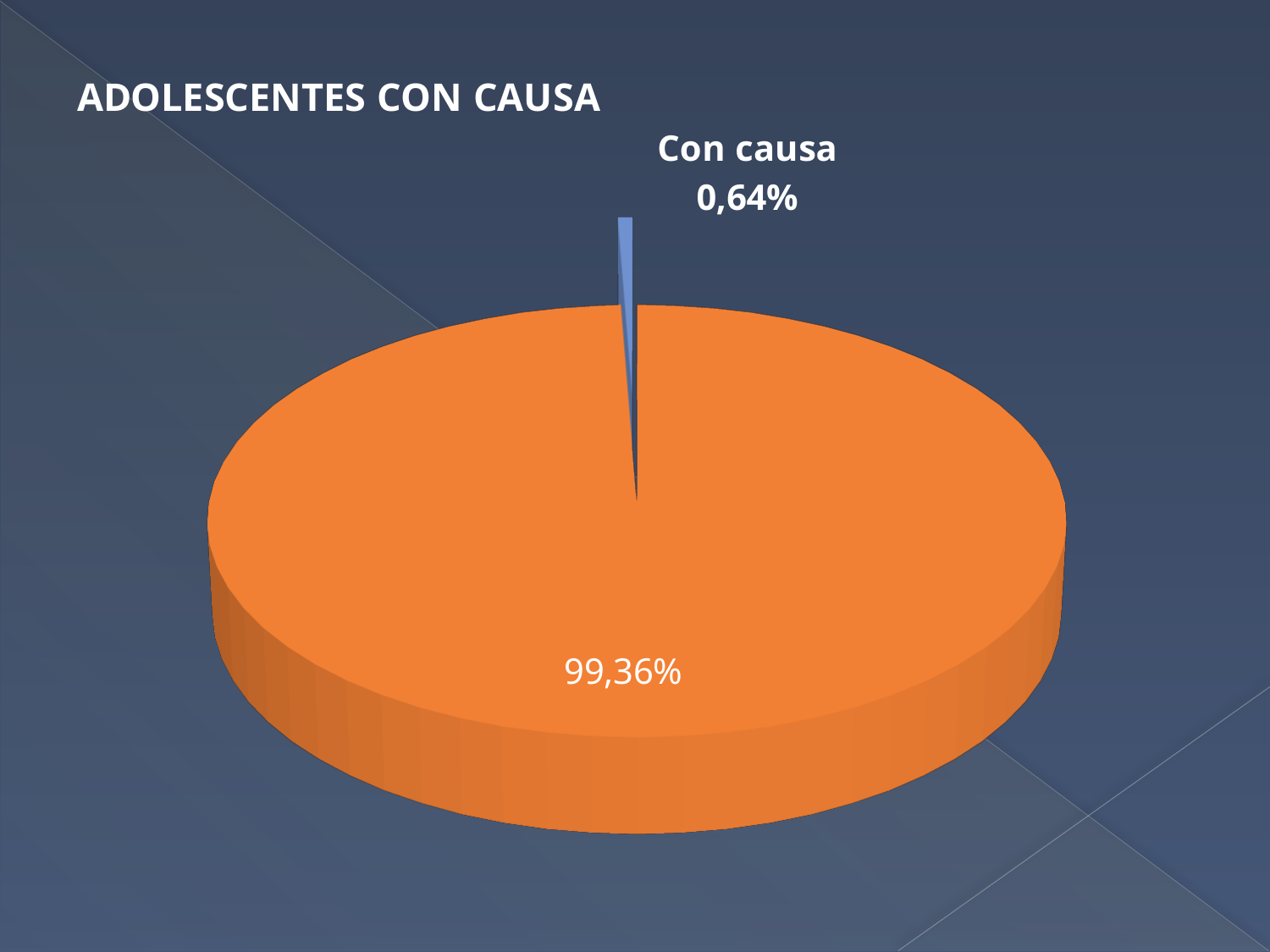
Which is larger: the "Con causa" slice or the orange slice? The orange slice What type of chart is shown on the slide? Pie chart What percentage is shown on the large orange slice of the pie? 99,36% Is the value of the "Con causa" slice greater or less than 1%? less What share of the pie does the orange slice represent? 99,36% How many slices does the pie chart have? 2 What is the title of the chart? ADOLESCENTES CON CAUSA Which slice is the smallest in the pie chart? Con causa What colour is the "Con causa" slice? Blue What percentage is shown for the "Con causa" slice? 0,64% What is the difference between the orange slice's value and the "Con causa" value? 98,72%